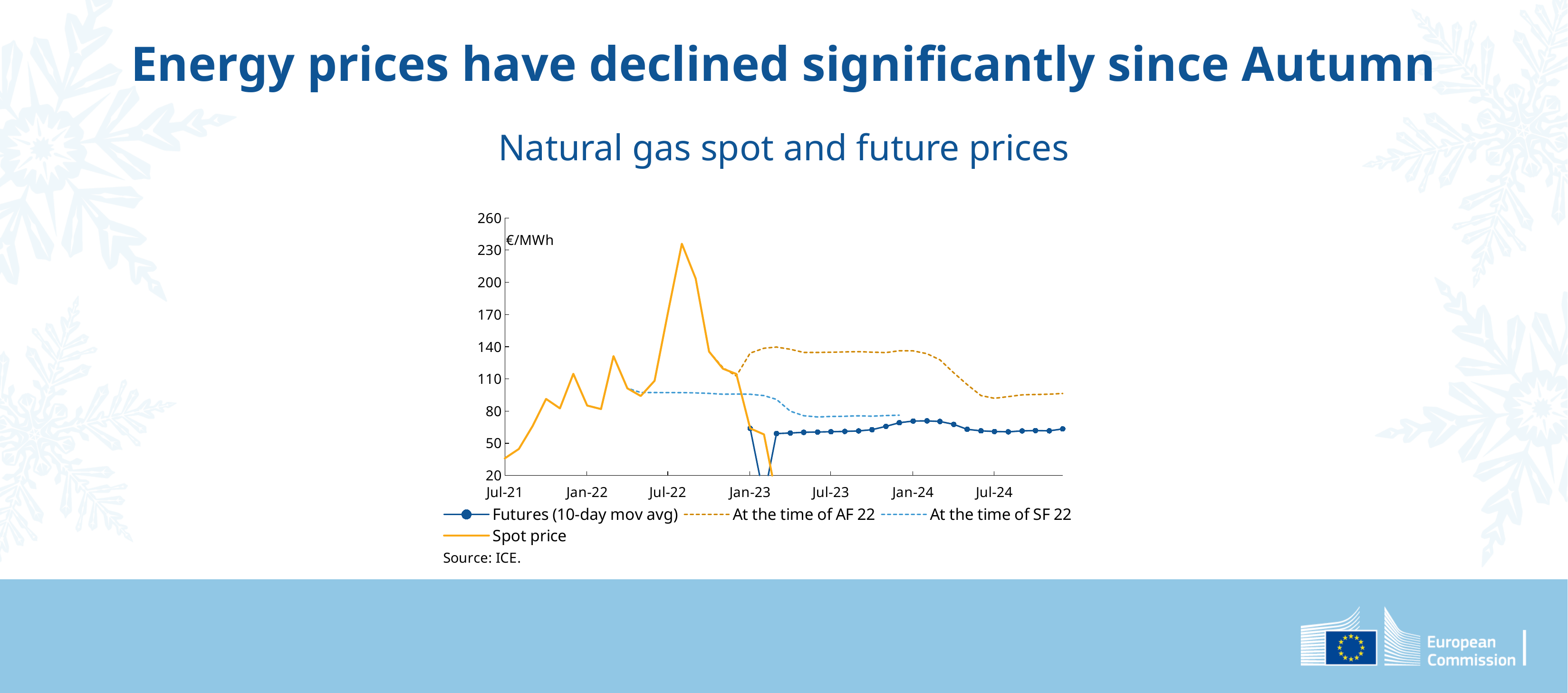
Around Jul-23, which series is higher: 'At the time of AF 22' or 'At the time of SF 22'? At the time of AF 22 How many series does the chart legend list? 4 Is the 'At the time of SF 22' value around Jul-23 greater or less than 110? less Does the Spot price generally rise or fall between Jul-21 and Jul-22? rise Is the Spot price at Jul-21 greater or less than 50? less What is the title of the chart? Natural gas spot and future prices What unit is shown on the chart's vertical axis? €/MWh Is the 'At the time of AF 22' value around Jul-23 greater or less than 110? greater Which series reaches the highest value on the chart? Spot price What kind of chart is shown on the slide? line chart